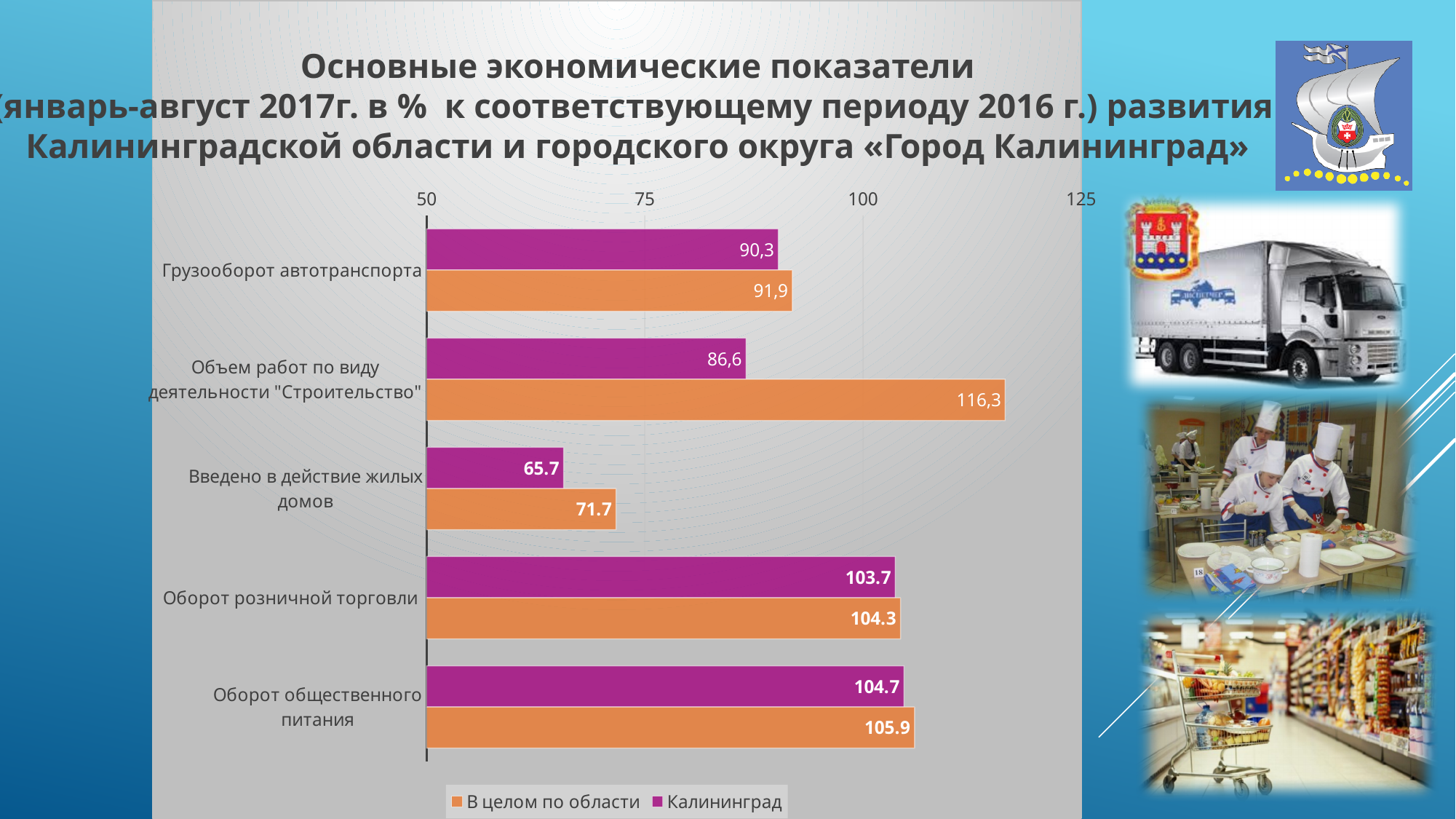
Is the value for Калининград in the category Оборот розничной торговли greater or less than 100? greater Which colour represents the series Калининград in the chart? purple Which category has the lowest value for the series Калининград? Введено в действие жилых домов What is the value for Калининград in the category Оборот общественного питания? 104.7 What is the value for В целом по области in the category Введено в действие жилых домов? 71.7 What is the difference between В целом по области and Калининград in the category Объем работ по виду деятельности "Строительство"? 29,7 Which is larger in the category Грузооборот автотранспорта: the value for В целом по области or for Калининград? В целом по области What is the value for Калининград in the category Объем работ по виду деятельности "Строительство"? 86,6 What kind of chart is shown on the slide? bar chart How many series does the legend list? 2 Which category has the highest value for the series В целом по области? Объем работ по виду деятельности "Строительство" How many categories are shown on the chart? 5